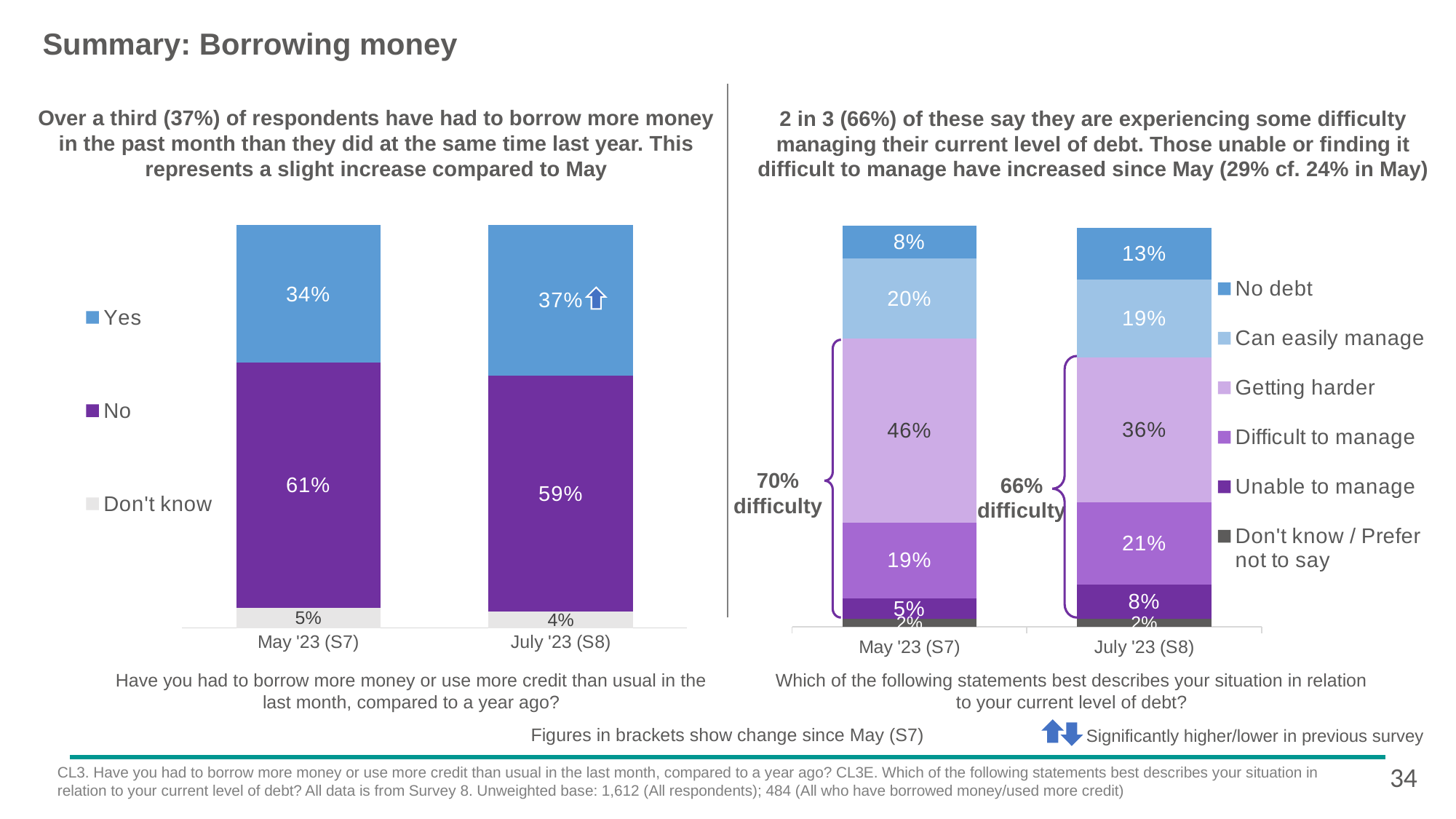
In the left chart (borrowing more money), how many series does the legend list? 3 In the left chart (borrowing more money), what percentage answered 'No' in May '23 (S7)? 61% In the left chart (borrowing more money), what is the difference between the 'No' share in May '23 (S7) and July '23 (S8)? 2 percentage points What type of chart is used on the left side of the slide (borrowing more money)? Stacked bar chart In the right chart (current level of debt), what is the difference between the 'Getting harder' share in May '23 (S7) and July '23 (S8)? 10 percentage points In the right chart (current level of debt), what percentage said 'No debt' in May '23 (S7)? 8% In the right chart (current level of debt), is the 'Unable to manage' share larger in May '23 (S7) or July '23 (S8)? July '23 (S8) In the right chart (current level of debt), which segment is the largest in the May '23 (S7) bar? Getting harder In the left chart (borrowing more money), what percentage of respondents answered 'Yes' in July '23 (S8)? 37% In the right chart (current level of debt), how many series does the legend list? 6 In the left chart (borrowing more money), does the 'Yes' share rise or fall from May '23 to July '23? rise In the right chart (current level of debt), what percentage said 'Getting harder' in July '23 (S8)? 36%